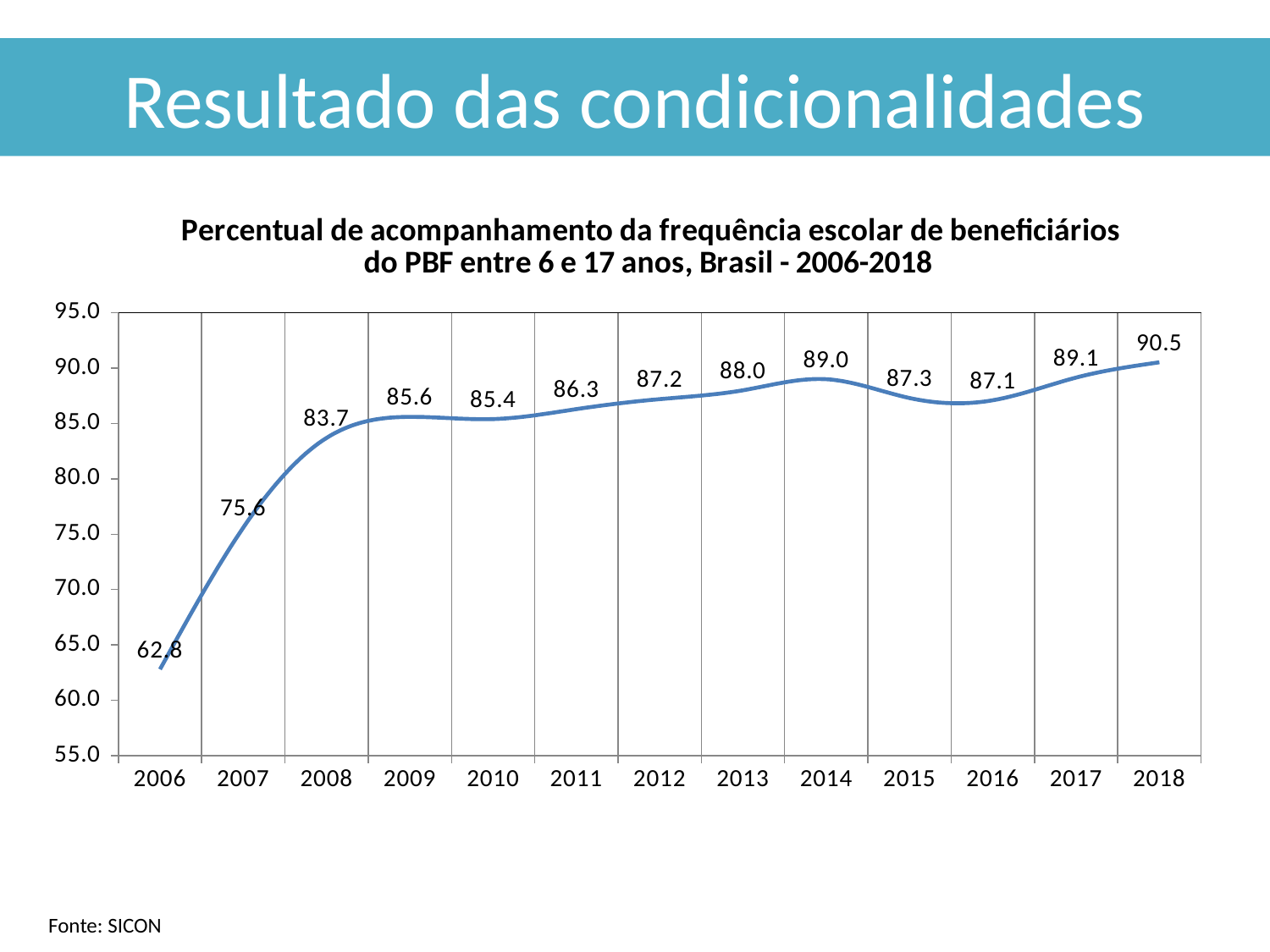
What is the value for 2006? 62.8 Which year has the highest value? 2018 Is the value for 2008 greater or less than 80.0? greater How many years are plotted on the chart? 13 What is the value for 2014? 89.0 What is the difference between the values for 2007 and 2006? 12.8 Which year has the lowest value? 2006 Do the values generally rise or fall from 2006 to 2018? rise What is the difference between the values for 2018 and 2006? 27.7 Which is larger, the value for 2014 or the value for 2015? 2014 What kind of chart is shown? line chart What is the value for 2018? 90.5